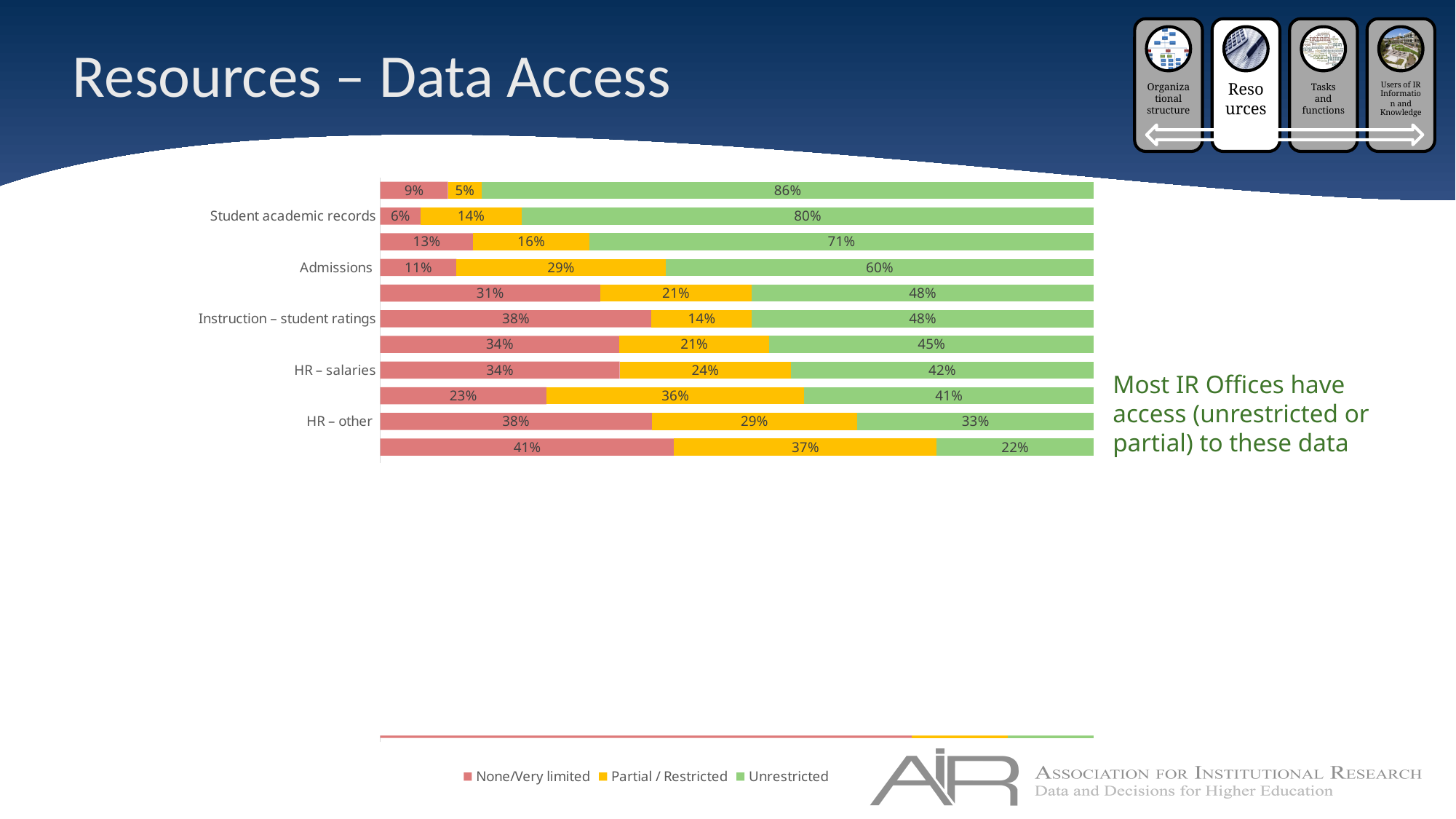
What is the Unrestricted value for HR – salaries? 42% Which access level has the smallest share for Student academic records? None/Very limited Which has a larger Unrestricted value, Admissions or Instruction – student ratings? Admissions How many series does the legend list? 3 What kind of chart is shown on the slide? Stacked bar chart What percentage of IR offices have Unrestricted access to Student academic records? 80% What is the None/Very limited value for HR – other? 38% What is the Partial / Restricted value for Admissions? 29% What colour represents Unrestricted in the legend? Green Which access level has the largest share for HR – other? None/Very limited What is the difference between the Unrestricted value for Student academic records and the Unrestricted value for HR – other? 47% What is the total of the three segments in the Admissions bar? 100%